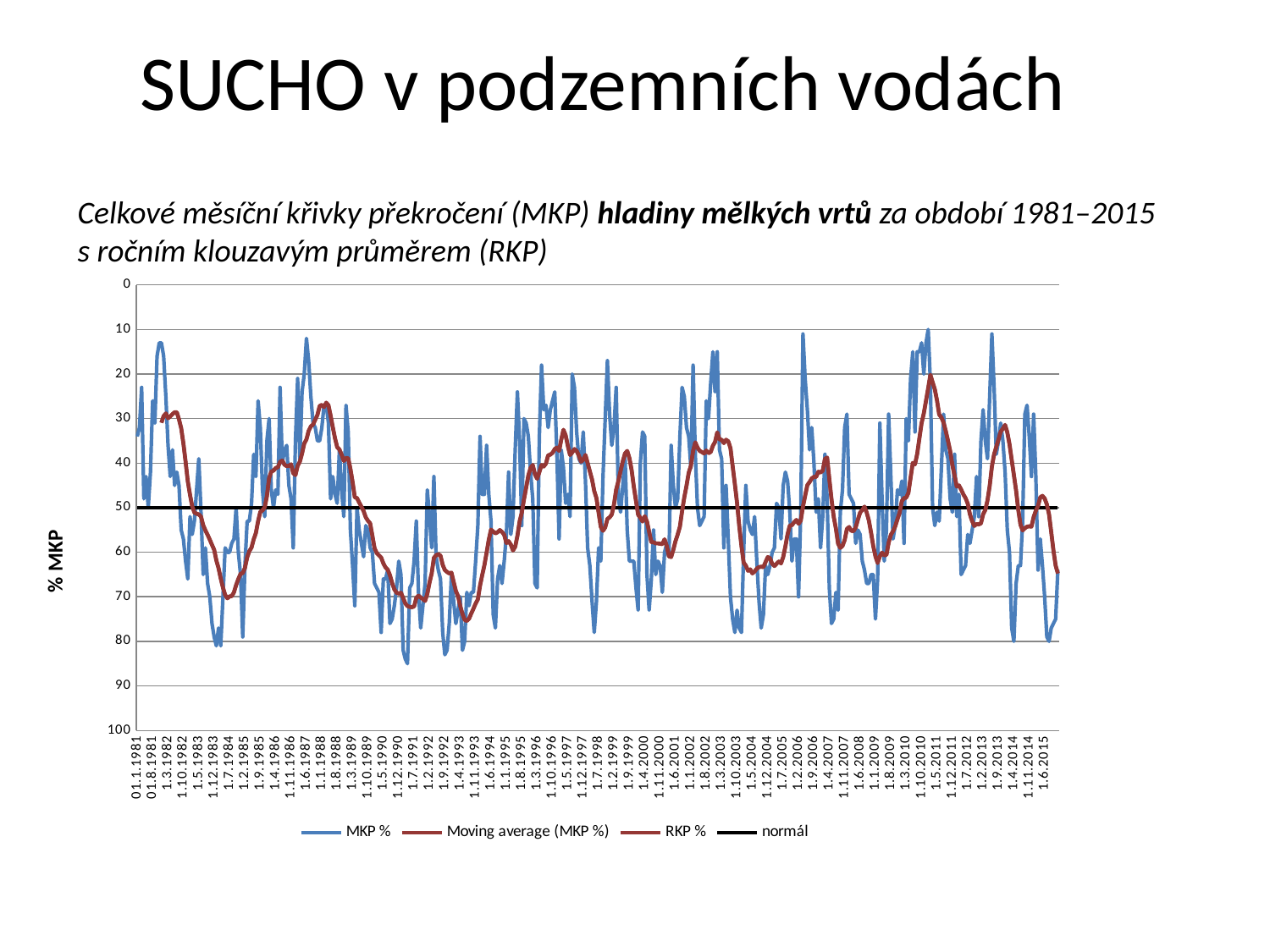
Is the RKP % value around 1.1.1988 greater or less than 40? less Between 1.7.1984 and 1.1.1988, does the RKP % value rise or fall? fall Is the RKP % value around 1.5.2011 greater or less than 30? less What colour is the MKP % line in the chart? blue How many series does the chart legend list? 4 What kind of chart is shown on the slide? line chart At which value on the vertical axis is the horizontal 'normál' line drawn? 50 Between 1.1.1988 and 1.7.1991, does the RKP % value rise or fall? rise What is the label of the vertical axis of the chart? % MKP Is the RKP % value around 1.7.1991 greater or less than 60? greater What is the maximum value shown on the vertical axis of the chart? 100